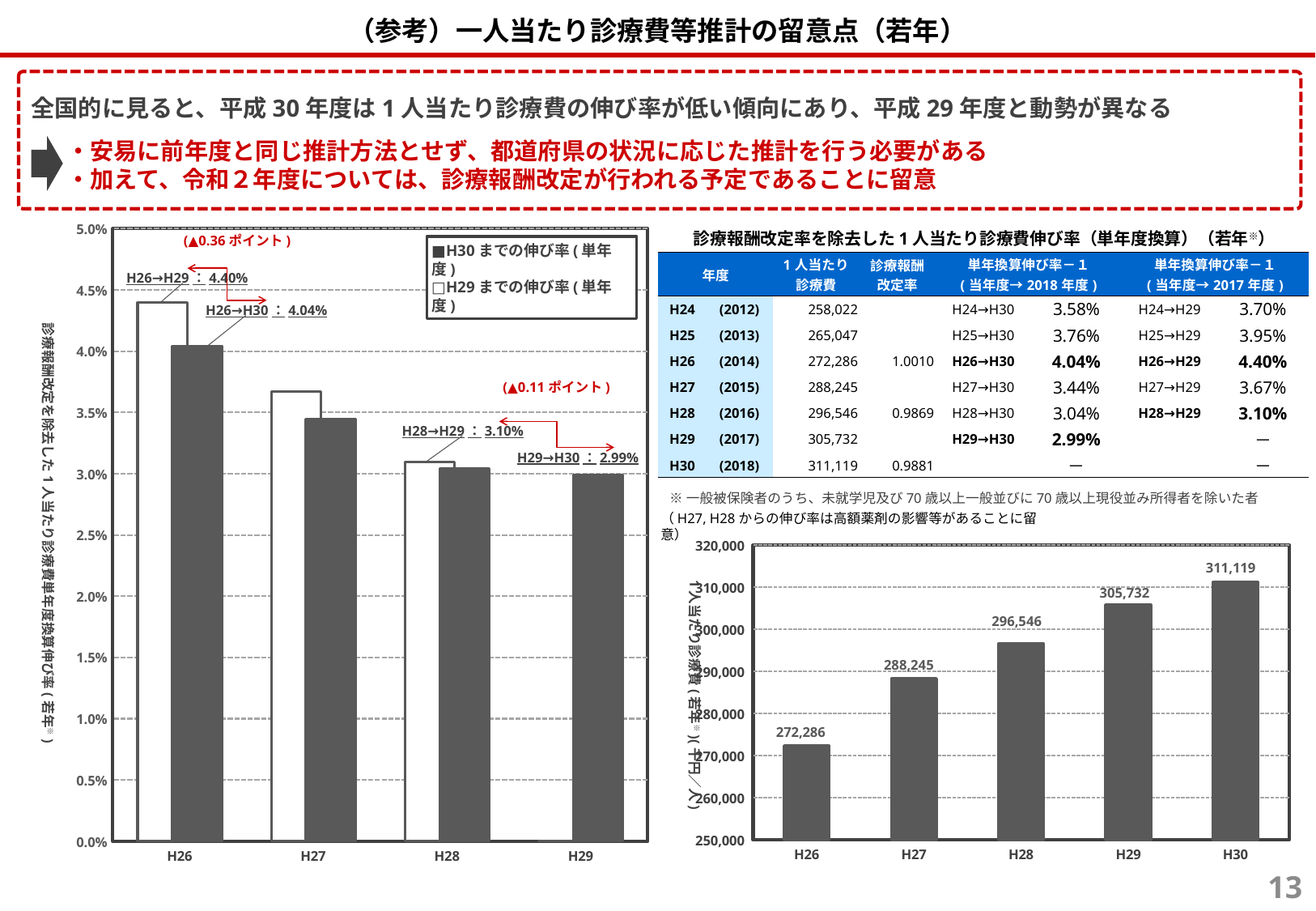
In the bar chart at the bottom right, do the values rise or fall from H26 to H30? rise In the bar chart at the bottom right, which year has the lowest value? H26 In the left bar chart, what is the value for H29 in the H30までの伸び率 series? 2.99% In the left bar chart, what is the value for H26 in the H30までの伸び率 series? 4.04% In the left bar chart, is the H29までの伸び率 value for H27 greater or less than 3.5%? greater How many years are shown on the x axis of the bar chart at the bottom right? 5 How many series does the legend of the left bar chart list? 2 In the bar chart at the bottom right, what is the difference between the values for H30 and H29? 5,387 In the bar chart at the bottom right, what is the value for H30? 311,119 In the left bar chart, what is the difference between the H29までの伸び率 and H30までの伸び率 values for H26? 0.36 ポイント What kind of chart is the chart on the left of the slide? bar chart In the left bar chart, what is the value for H26 in the H29までの伸び率 series? 4.40%